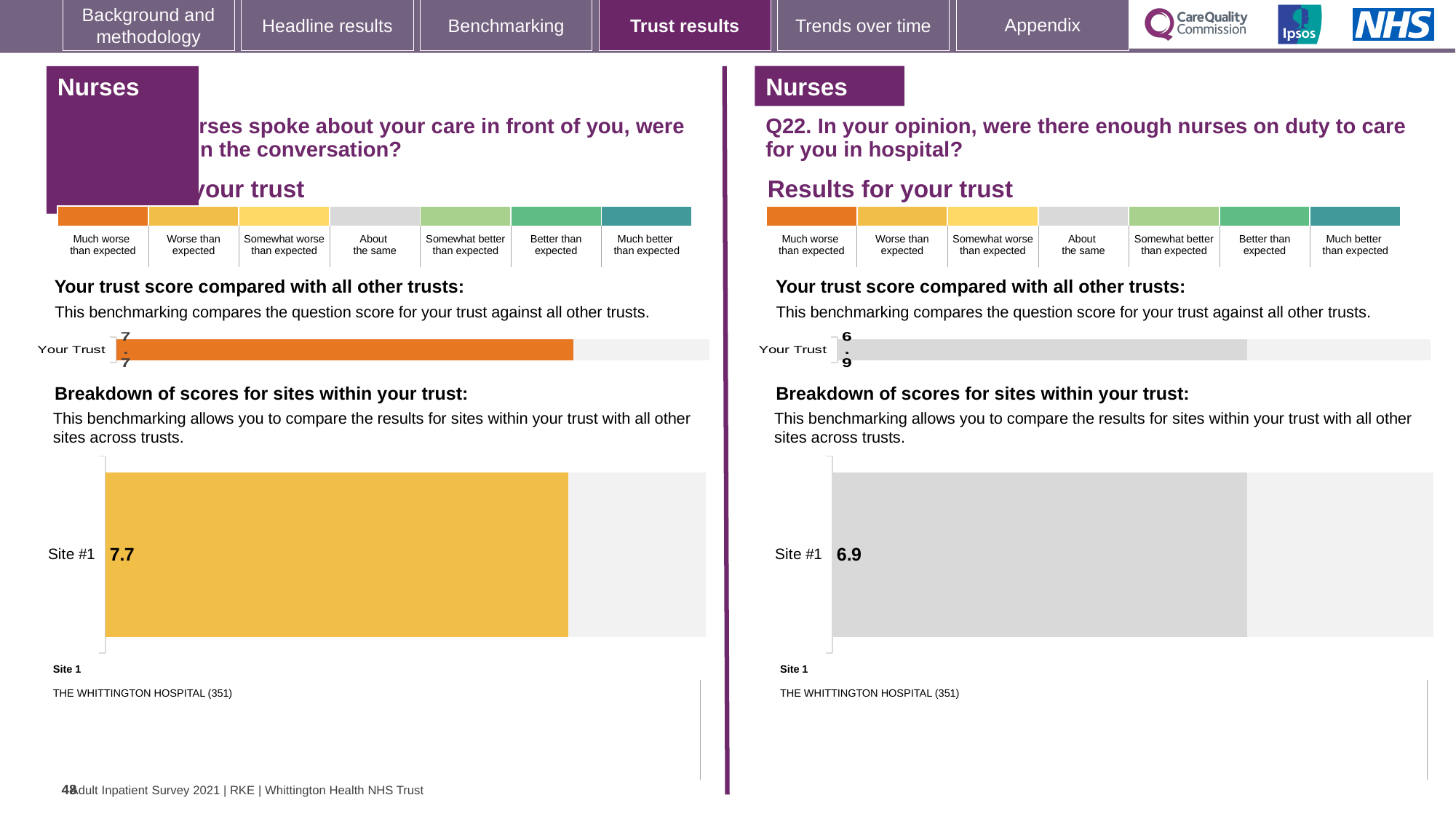
On the left-hand panel, what is the score shown for Site #1? 7.7 How many sites are shown in the breakdown of scores chart on the left-hand panel? 1 On the left-hand panel, what is the score shown for Your Trust? 7.7 On the right-hand panel (Q22), what is the score shown for Your Trust? 6.9 Which site name is listed as Site 1 on the right-hand panel (Q22)? THE WHITTINGTON HOSPITAL (351) How many sites are shown in the breakdown of scores chart on the right-hand panel (Q22)? 1 On the left-hand panel, what colour is the Site #1 bar? Yellow On the right-hand panel (Q22), what is the score shown for Site #1? 6.9 What kind of chart is used to show the Site #1 score on the right-hand panel (Q22)? Bar chart What is the difference between the Site #1 score on the left-hand panel and the Site #1 score on the right-hand panel (Q22)? 0.8 On the right-hand panel (Q22), what colour is the Site #1 bar? Grey Which is larger: the Your Trust score on the left-hand panel or the Your Trust score on the right-hand panel (Q22)? Left-hand panel